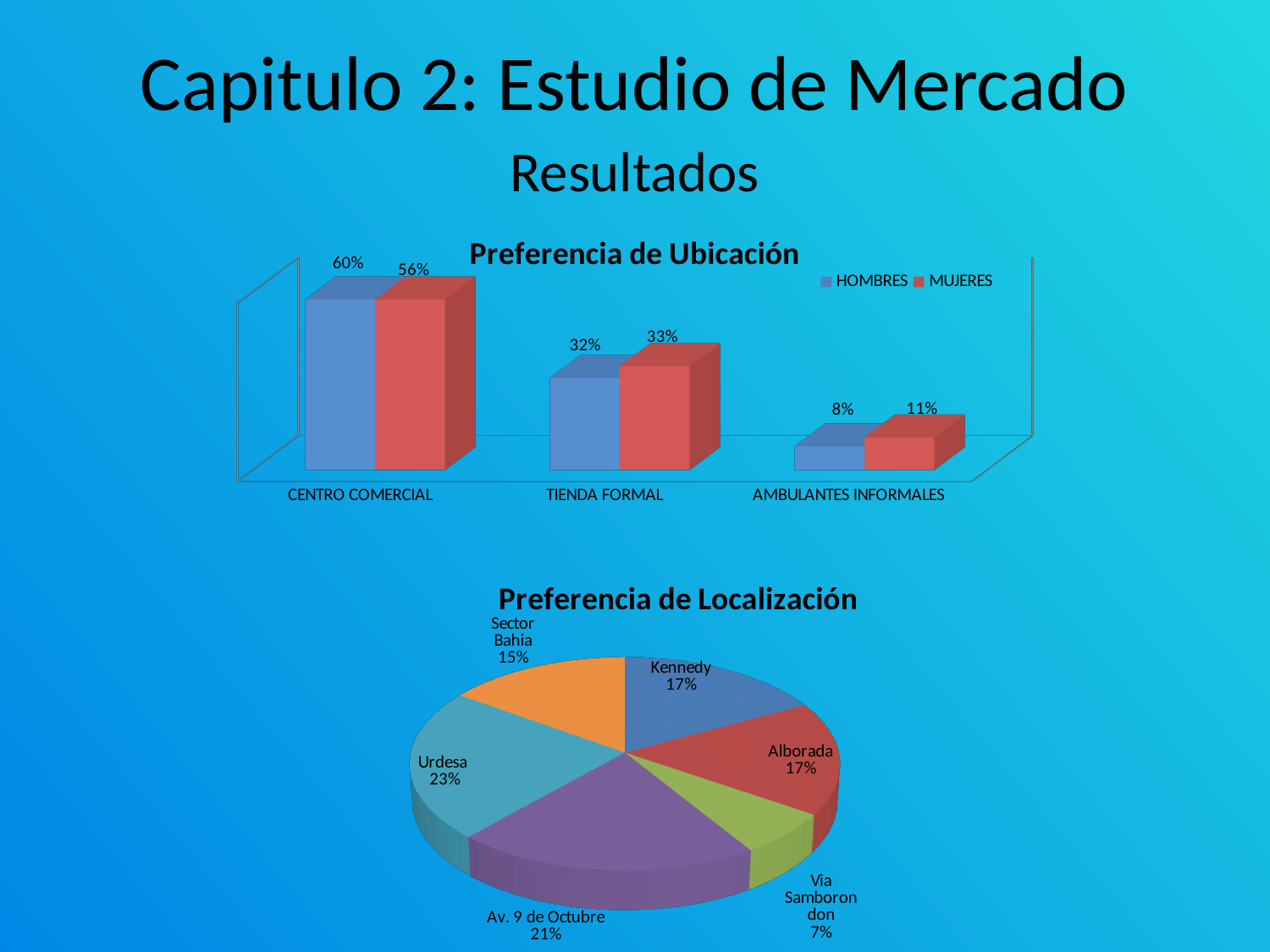
In the 'Preferencia de Ubicación' chart, which is larger at TIENDA FORMAL: HOMBRES or MUJERES? MUJERES In the 'Preferencia de Localización' chart, what share does Urdesa have? 23% In the 'Preferencia de Localización' chart, which location has the smallest slice? Via Samborondon How many slices does the 'Preferencia de Localización' pie chart have? 6 What kind of chart is 'Preferencia de Ubicación'? Bar chart In the 'Preferencia de Ubicación' chart, which category has the highest value for MUJERES? CENTRO COMERCIAL How many series does the legend of the 'Preferencia de Ubicación' chart list? 2 In the 'Preferencia de Ubicación' chart, what is the value for MUJERES at AMBULANTES INFORMALES? 11% In the 'Preferencia de Localización' chart, what is the difference between the shares of Urdesa and Sector Bahia? 8% In the 'Preferencia de Ubicación' chart, what is the value for HOMBRES at CENTRO COMERCIAL? 60% In the 'Preferencia de Ubicación' chart, what is the difference between HOMBRES and MUJERES at CENTRO COMERCIAL? 4% In the 'Preferencia de Ubicación' chart, which category has the lowest value for HOMBRES? AMBULANTES INFORMALES